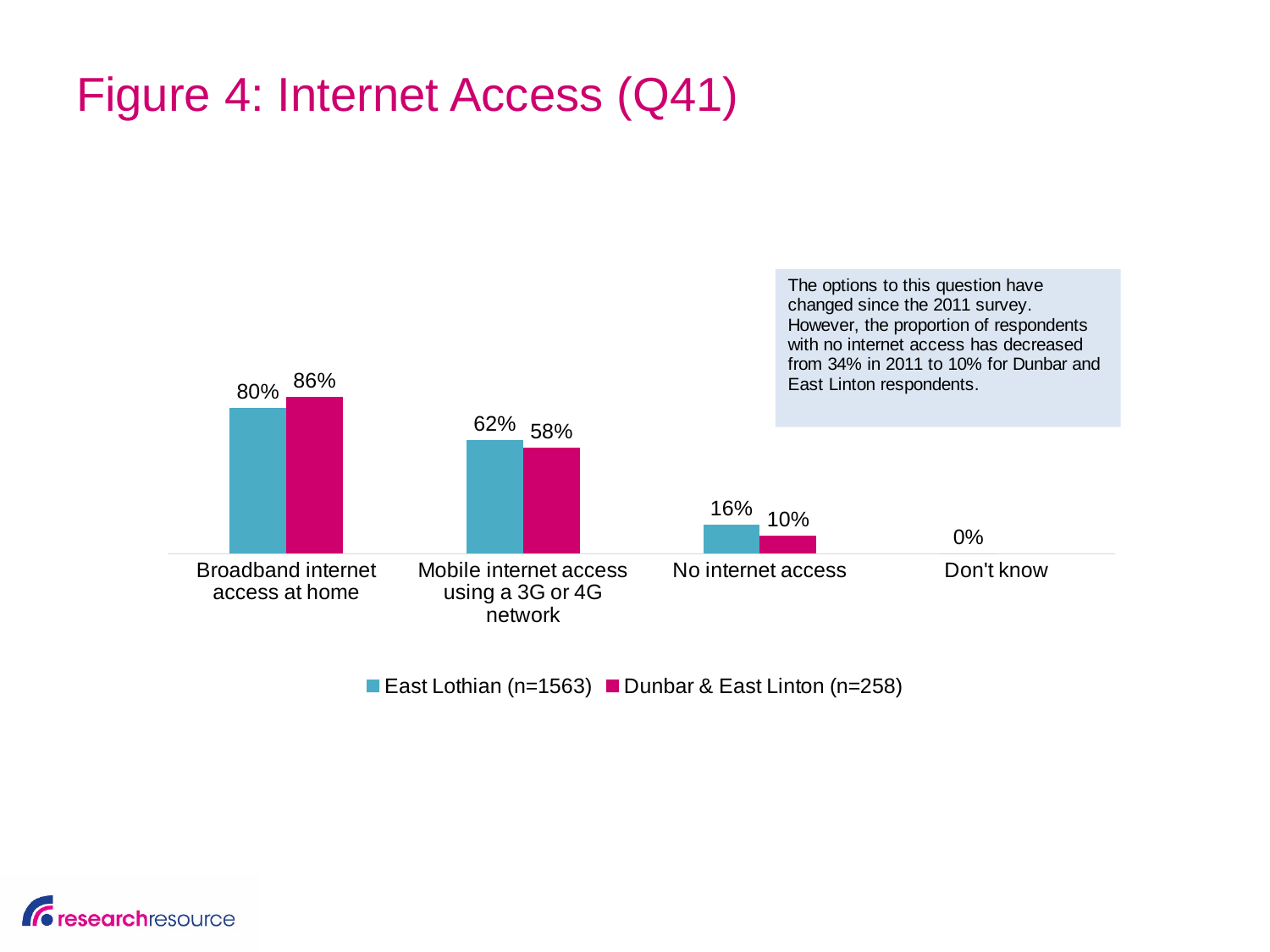
What is the value for East Lothian for mobile internet access using a 3G or 4G network? 62% For mobile internet access using a 3G or 4G network, which series has the larger value, East Lothian or Dunbar & East Linton? East Lothian What is the difference between the East Lothian and Dunbar & East Linton values for no internet access? 6% What percentage of Dunbar & East Linton respondents have broadband internet access at home? 86% How many series does the legend list? 2 Which category has the highest value for East Lothian? Broadband internet access at home What is the difference between the Dunbar & East Linton and East Lothian values for broadband internet access at home? 6% How many categories are shown on the x axis of the chart? 4 What percentage of East Lothian respondents have broadband internet access at home? 80% What is the value for Dunbar & East Linton for no internet access? 10% What type of chart is shown on the slide? Bar chart